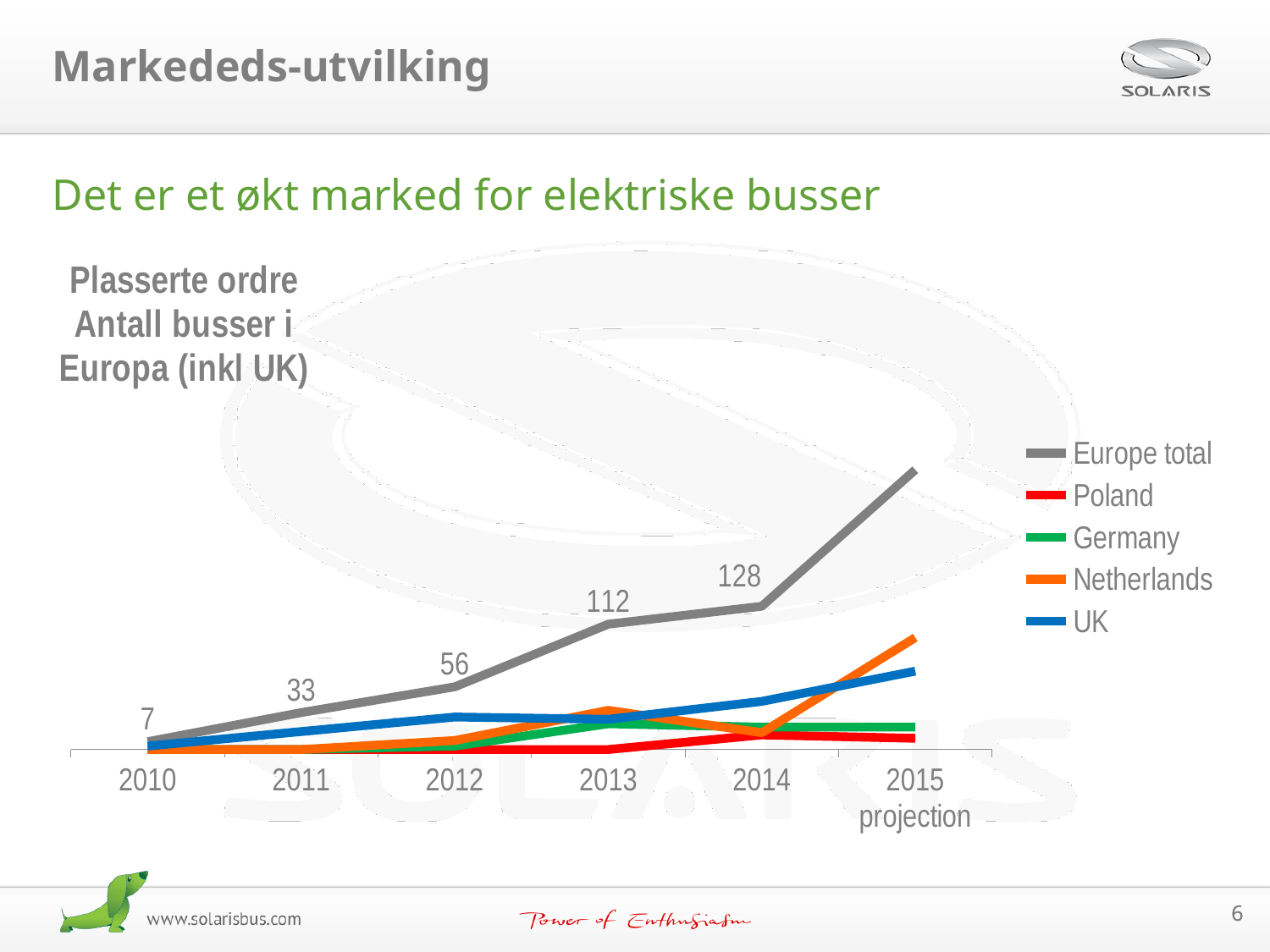
What is the Europe total value for 2012? 56 What is the Europe total value for 2014? 128 Which year has the lowest Europe total value? 2010 What is the Europe total value for 2013? 112 What is the difference between the Europe total values for 2014 and 2013? 16 How many series does the legend list? 5 How many years are shown on the x axis? 6 In the 2015 projection, which is higher: Netherlands or UK? Netherlands What is the Europe total value for 2010? 7 What is the difference between the Europe total values for 2013 and 2012? 56 Which year has the highest Europe total value? 2015 projection What kind of chart is shown on the slide? Line chart